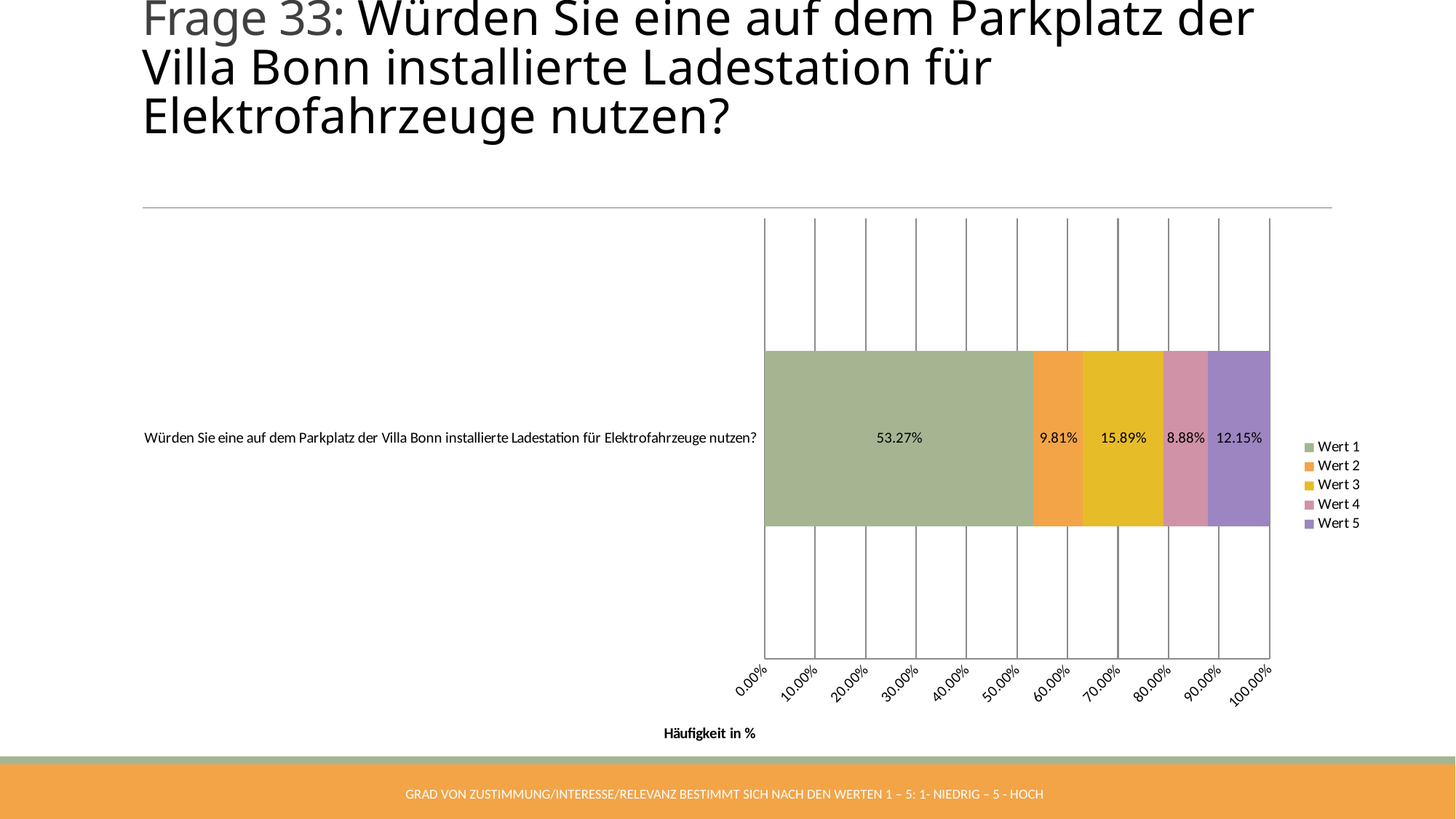
What is the value for Wert 2? 9.81% What is the total of the stacked bar? 100.00% Which series has the lowest value? Wert 4 What is the value for Wert 5? 12.15% Which series has the highest value? Wert 1 What kind of chart is shown on the slide? Stacked bar chart What is the value for Wert 3? 15.89% What is the title of the x axis? Häufigkeit in % Which is larger, the value for Wert 5 or the value for Wert 2? Wert 5 How many series does the legend list? 5 What is the value for Wert 1? 53.27% What is the difference between the values for Wert 1 and Wert 3? 37.38%